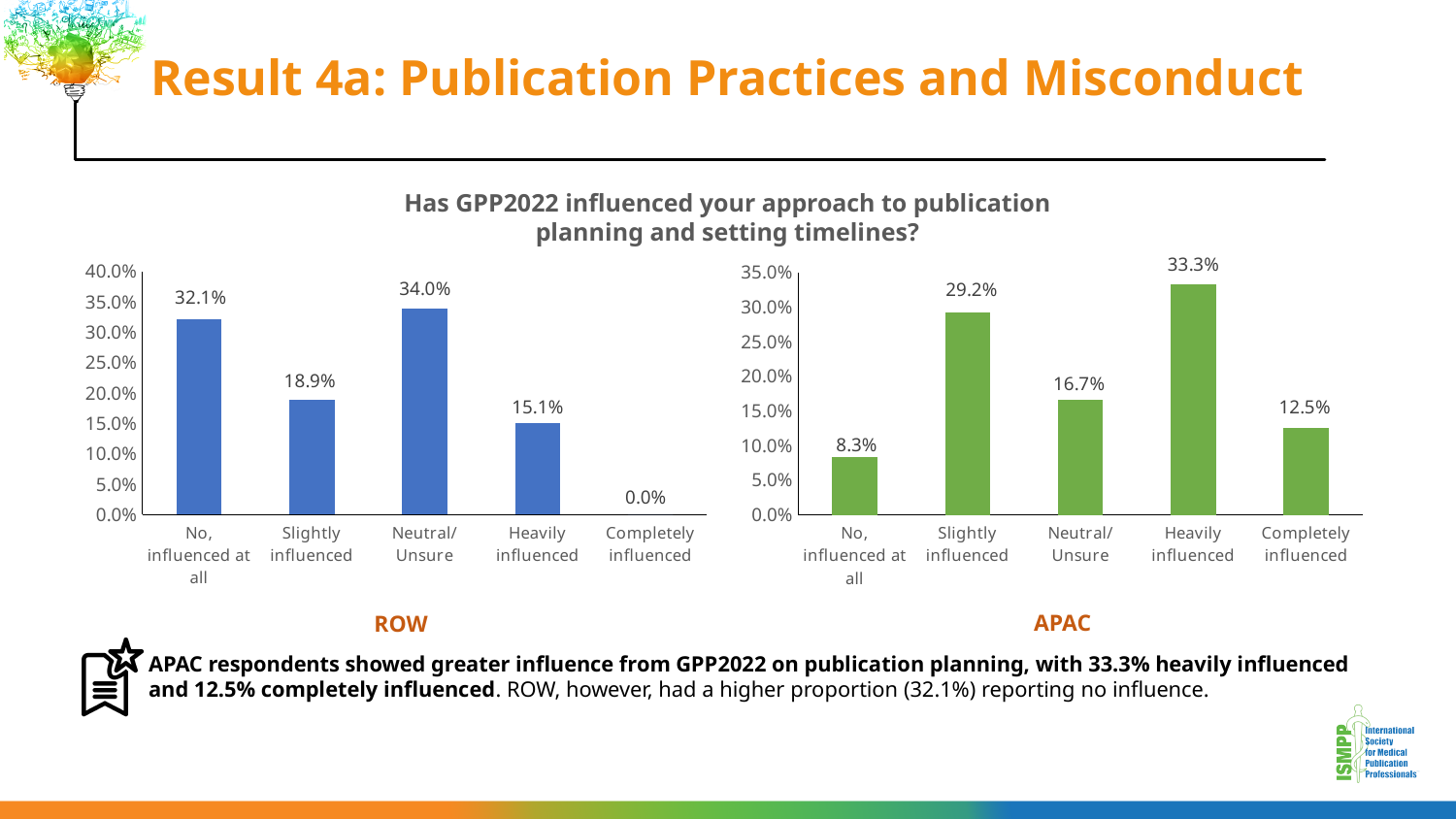
In the ROW chart, what is the difference between 'No, influenced at all' and 'Slightly influenced'? 13.2% What type of chart is used for the APAC data? Bar chart In the APAC chart, what is the difference between 'Heavily influenced' and 'Completely influenced'? 20.8% In the APAC chart, which category has the lowest value? No, influenced at all Which is larger: the 'Slightly influenced' value in the ROW chart or in the APAC chart? APAC In the ROW chart, what is the value for 'Completely influenced'? 0.0% In the APAC chart, is the value for 'Slightly influenced' greater or less than 25.0%? greater In the ROW chart, which category has the highest value? Neutral/Unsure What colour are the bars in the ROW chart? Blue How many categories are shown on the x axis of the ROW chart? 5 In the ROW chart, what percentage of respondents answered 'Neutral/Unsure'? 34.0% In the APAC chart, what percentage of respondents answered 'Heavily influenced'? 33.3%